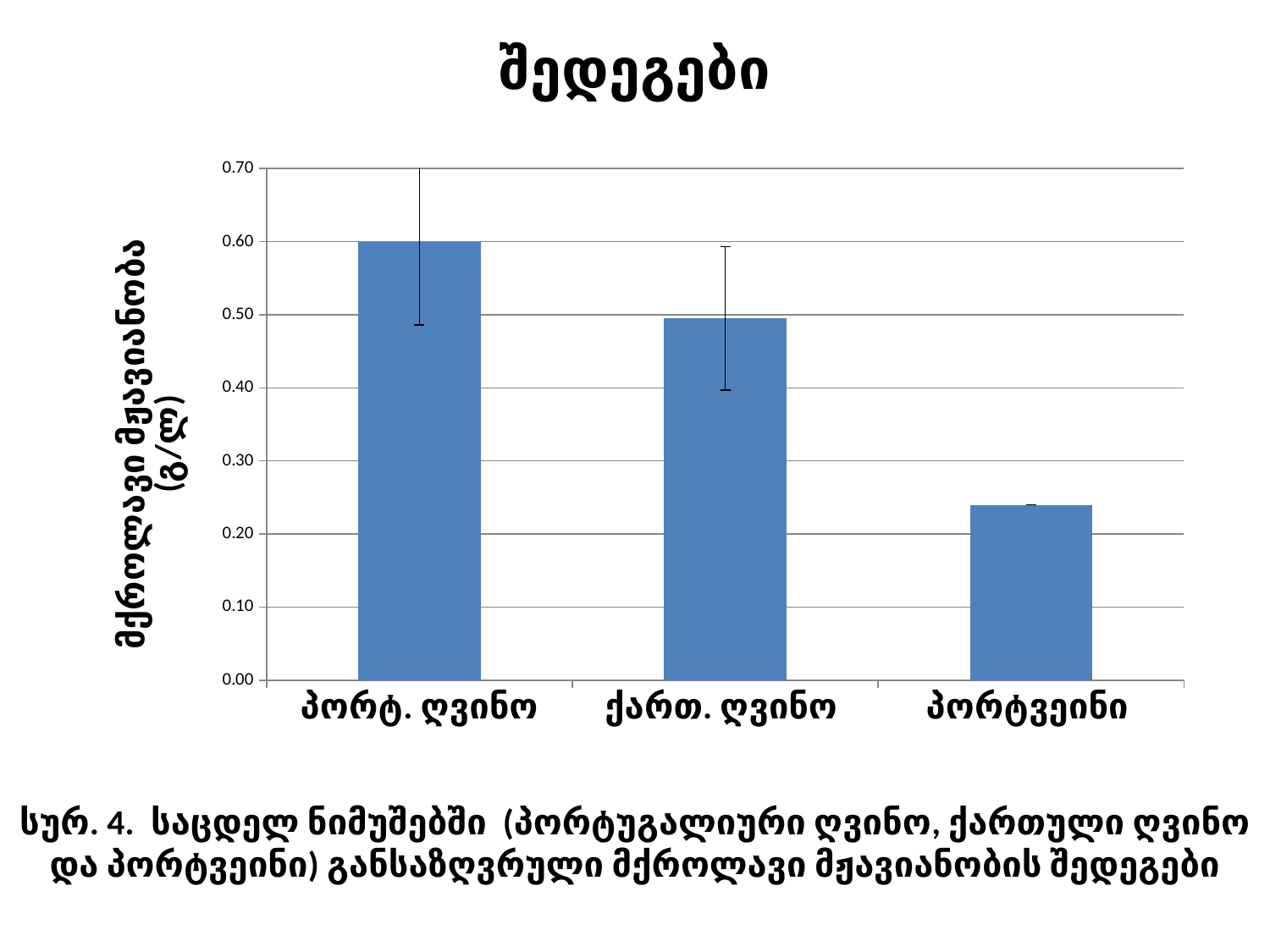
How many categories are plotted on the chart? 3 What kind of chart is shown on the slide? bar chart Which category has the highest value? პორტ. ღვინო Is the value for პორტ. ღვინო greater or less than 0.50? greater Which category has the lowest value? პორტვეინი Which is larger, the value for ქართ. ღვინო or the value for პორტვეინი? ქართ. ღვინო Is the value for ქართ. ღვინო greater or less than 0.40? greater What is the label of the vertical axis? მქროლავი მჟავიანობა (გ/ლ) Is the value for პორტვეინი greater or less than 0.20? greater Do the values rise or fall from left to right along the x axis? fall What is the title of the chart? შედეგები